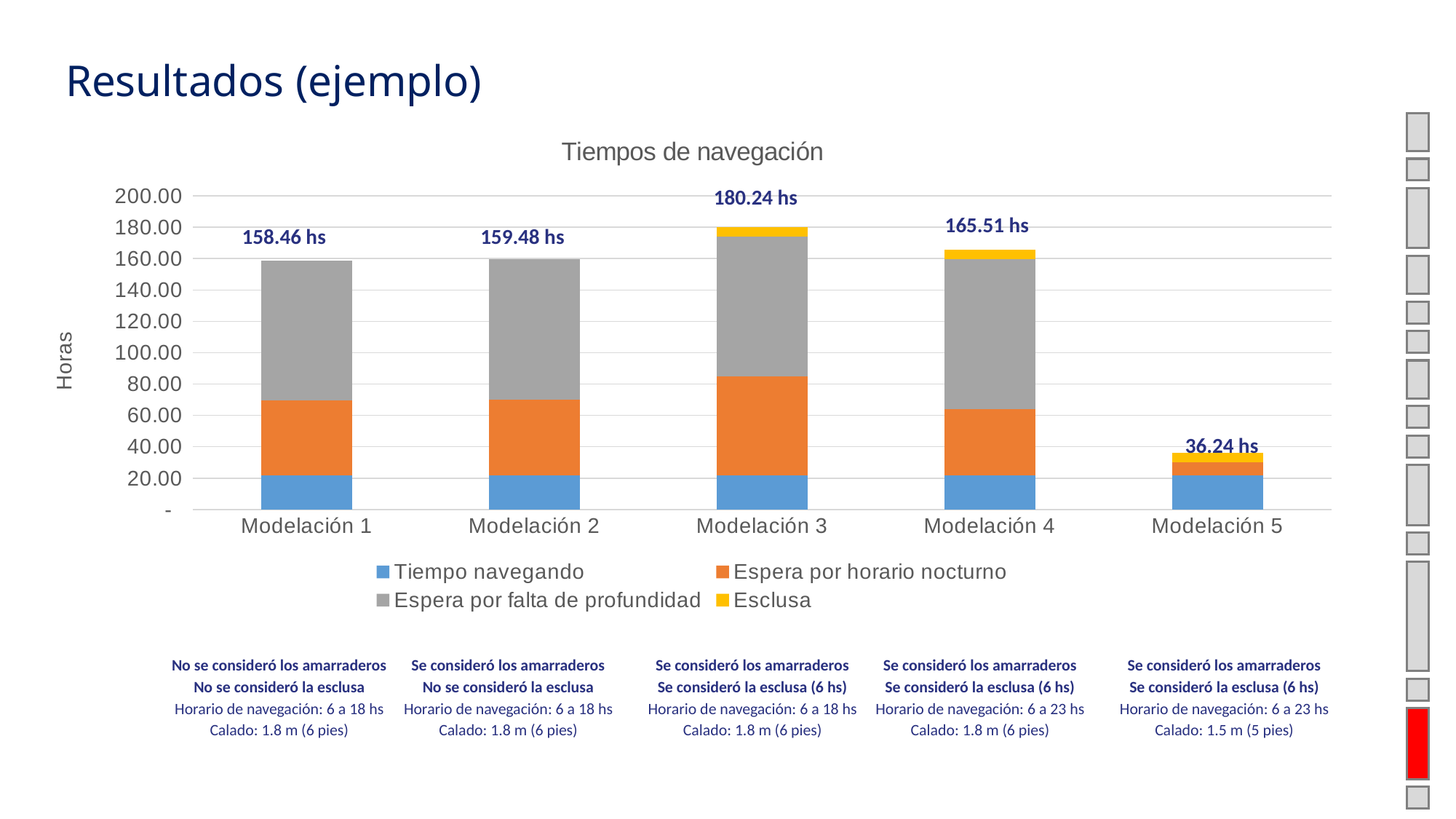
Which modelación has the lowest total navigation time? Modelación 5 How many modelaciones are shown on the x axis? 5 Which has a larger total, Modelación 4 or Modelación 2? Modelación 4 What kind of chart is shown on the slide? Stacked bar chart What is the total navigation time labelled for Modelación 3? 180.24 hs What is the total labelled for Modelación 1? 158.46 hs What is the difference between the totals for Modelación 4 and Modelación 5? 129.27 hs Which modelación has the highest total navigation time? Modelación 3 What is the difference between the totals for Modelación 3 and Modelación 1? 21.78 hs How many series does the legend list? 4 What is the total labelled above the bar for Modelación 5? 36.24 hs Is the Tiempo navegando value for Modelación 3 greater or less than 40? less